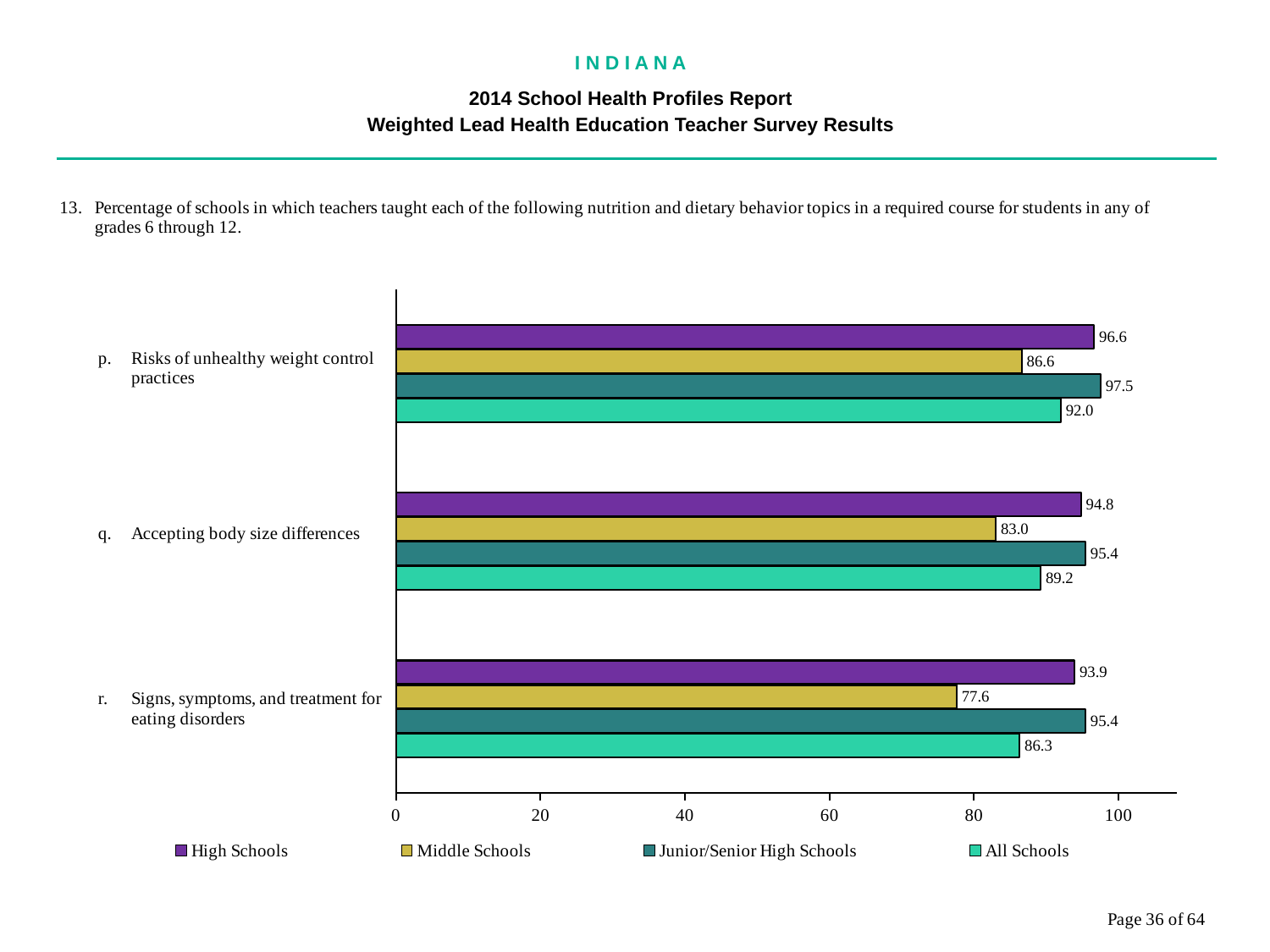
What is the value for All Schools for 'Accepting body size differences'? 89.2 What is the value for Middle Schools for 'Signs, symptoms, and treatment for eating disorders'? 77.6 Which is larger for 'Accepting body size differences': the High Schools value or the All Schools value? High Schools Is the Middle Schools value for 'Signs, symptoms, and treatment for eating disorders' greater or less than 80? less How many series does the legend list? 4 What kind of chart is shown on the slide? Bar chart Which series has the lowest value for 'Accepting body size differences'? Middle Schools What is the difference between the Junior/Senior High Schools and Middle Schools values for 'Signs, symptoms, and treatment for eating disorders'? 17.8 Which legend entry is shown in purple? High Schools Which series has the highest value for 'Risks of unhealthy weight control practices'? Junior/Senior High Schools What is the value for High Schools for 'Risks of unhealthy weight control practices'? 96.6 How many topics (categories) are shown on the chart? 3